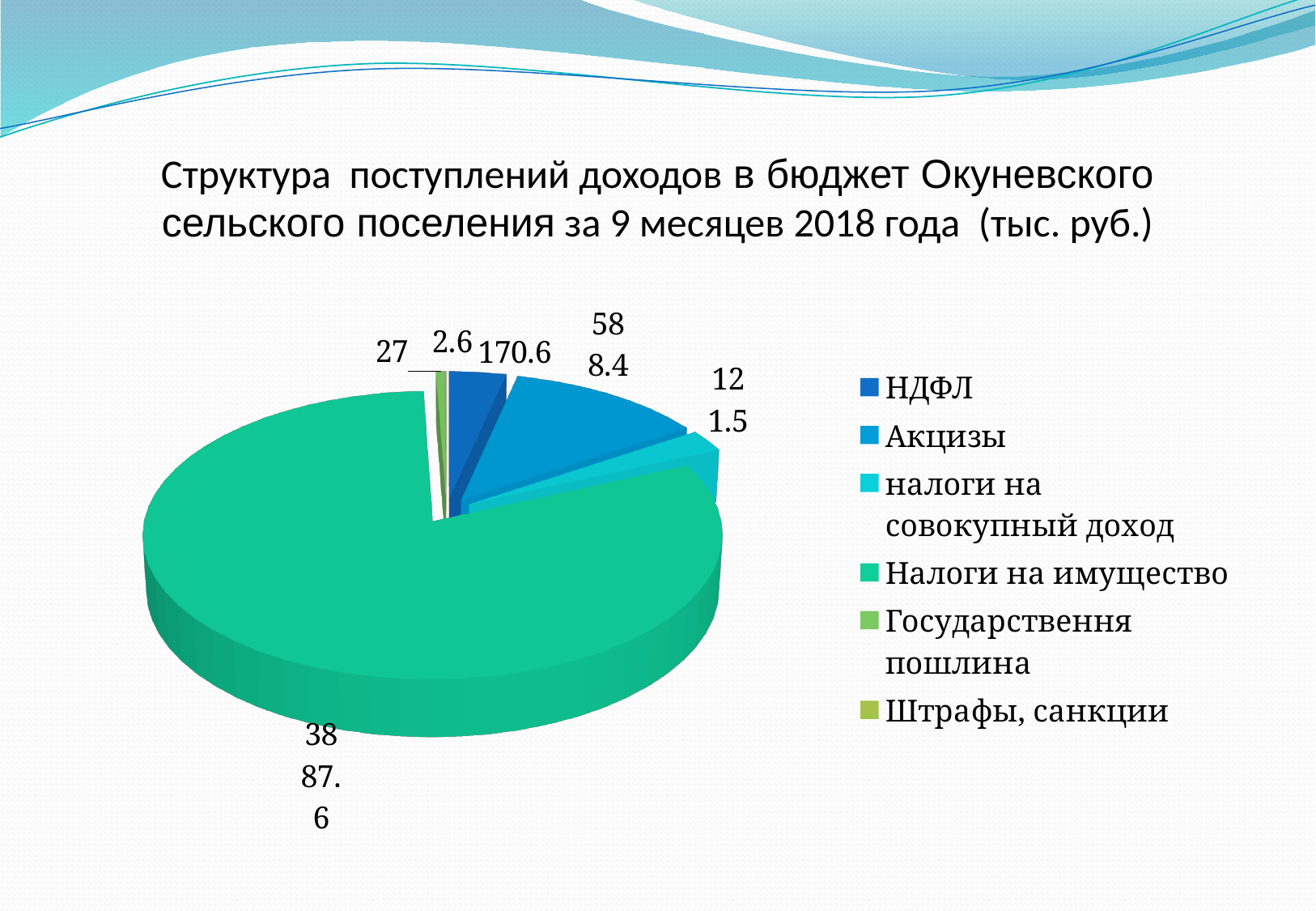
What is the difference between the values for Акцизы and НДФЛ? 417.8 What is the value for Акцизы? 588.4 Which category has the largest slice of the pie? Налоги на имущество How many entries does the legend list? 6 What is the value for Штрафы, санкции? 2.6 Which category has the smallest slice of the pie? Штрафы, санкции What kind of chart is shown on the slide? Pie chart What is the value for Государственная пошлина? 27 What is the value for налоги на совокупный доход? 121.5 What is the value for НДФЛ? 170.6 Which is larger, the value for Акцизы or the value for НДФЛ? Акцизы How many categories does the pie chart show? 6